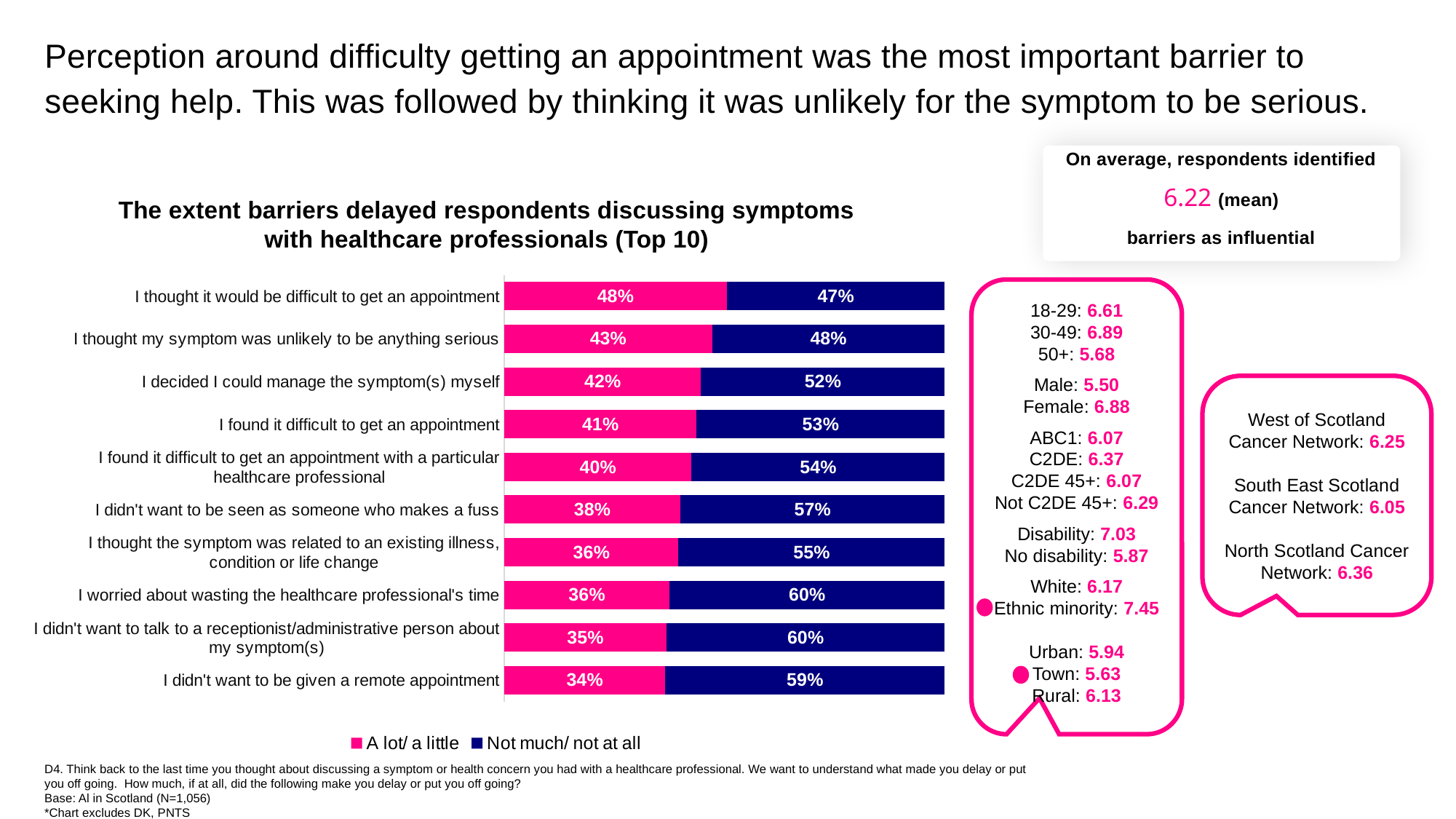
How many series does the legend list? 2 Which barrier has the lowest 'A lot/ a little' percentage? I didn't want to be given a remote appointment What is the total of the two segments for 'I worried about wasting the healthcare professional's time'? 96% What is the 'A lot/ a little' value for 'I didn't want to be given a remote appointment'? 34% Which is larger for 'I found it difficult to get an appointment': the 'A lot/ a little' share or the 'Not much/ not at all' share? Not much/ not at all Which barrier has the highest 'A lot/ a little' percentage? I thought it would be difficult to get an appointment What is the difference between the 'A lot/ a little' and 'Not much/ not at all' values for 'I didn't want to be seen as someone who makes a fuss'? 19 percentage points What kind of chart is shown on the slide? Stacked horizontal bar chart How many barriers are shown in the chart? 10 What percentage of respondents said 'I thought it would be difficult to get an appointment' delayed them a lot/a little? 48% What is the 'Not much/ not at all' value for 'I decided I could manage the symptom(s) myself'? 52% Which colour represents 'A lot/ a little' in the chart? Pink